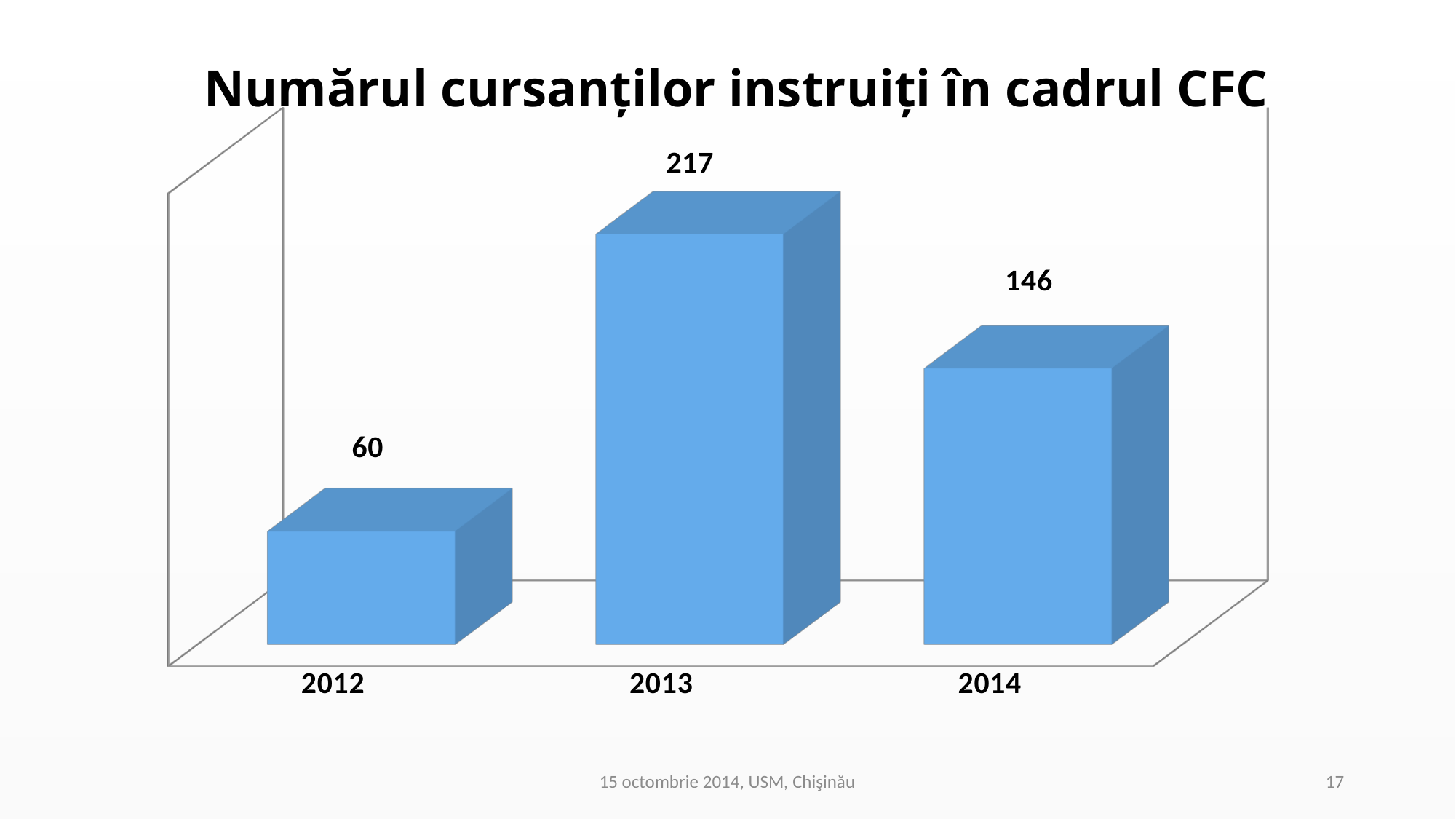
What is the value for 2012? 60 Which year has the lowest value? 2012 What is the value for 2013? 217 Which is larger, the value for 2012 or the value for 2014? 2014 Does the value rise or fall from 2013 to 2014? fall How many years are shown on the chart? 3 What is the title of the chart? Numărul cursanților instruiți în cadrul CFC What is the difference between the values for 2013 and 2014? 71 What is the value for 2014? 146 Which year has the highest value? 2013 What is the difference between the values for 2014 and 2012? 86 What kind of chart is shown on the slide? bar chart